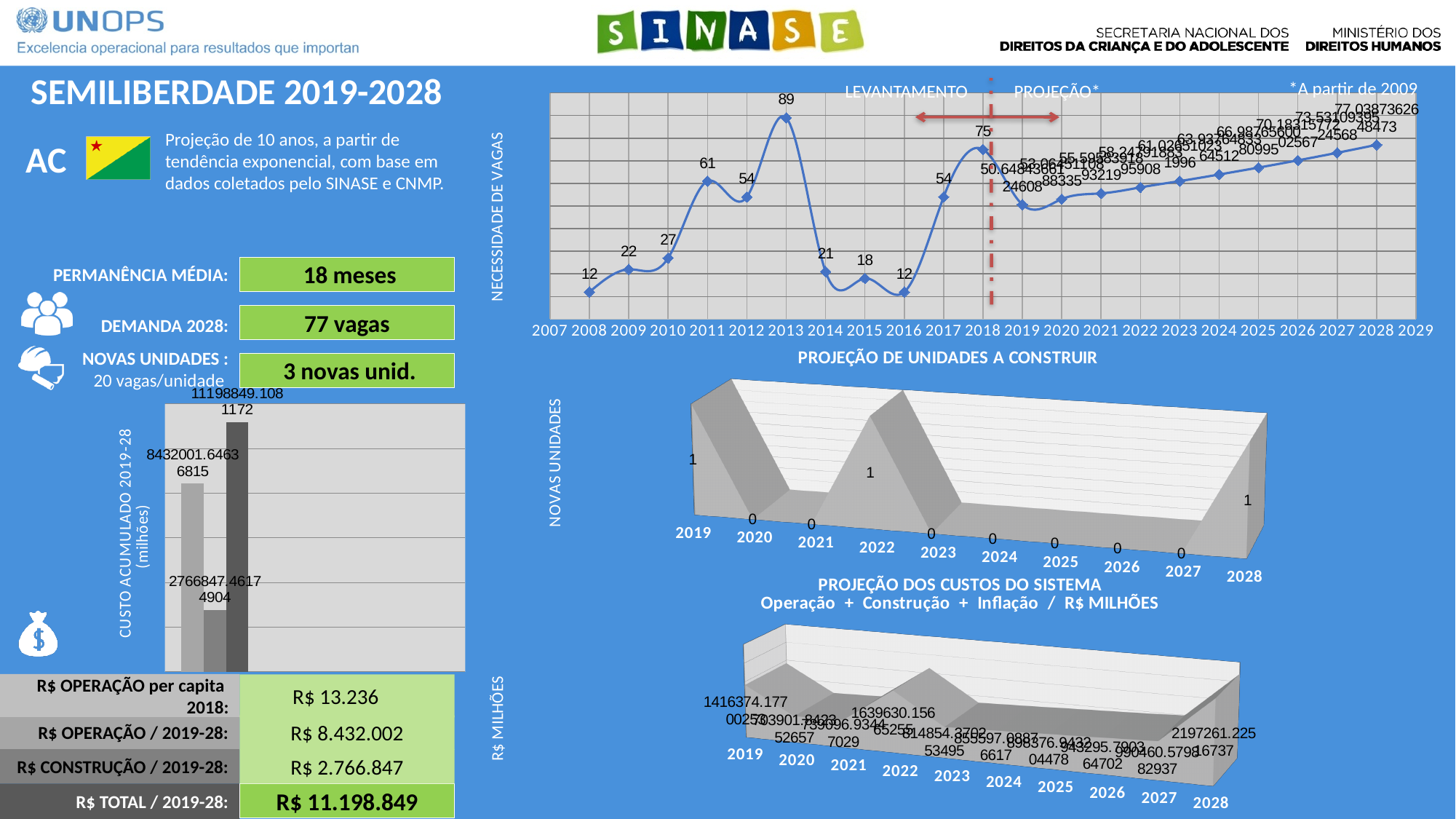
In the NECESSIDADE DE VAGAS line chart, what is the value for 2013? 89 In the PROJEÇÃO DE UNIDADES A CONSTRUIR chart, what is the value for 2022? 1 What kind of chart is the NECESSIDADE DE VAGAS chart at the top right? line chart In the NECESSIDADE DE VAGAS line chart, which year has the highest value? 2013 In the NECESSIDADE DE VAGAS line chart, which year has the larger value, 2011 or 2012? 2011 In the NECESSIDADE DE VAGAS line chart, do the projected values rise or fall from 2019 to 2028? rise In the NECESSIDADE DE VAGAS line chart, what is the value for 2015? 18 In the PROJEÇÃO DE UNIDADES A CONSTRUIR chart, how many years have a value of 1? 3 How many bars are in the CUSTO ACUMULADO 2019-28 bar chart on the left? 3 In the NECESSIDADE DE VAGAS line chart, what two labels appear on either side of the red dashed vertical line? LEVANTAMENTO and PROJEÇÃO In the NECESSIDADE DE VAGAS line chart, what is the value for 2018? 75 In the NECESSIDADE DE VAGAS line chart, what is the difference between the 2013 value and the 2018 value? 14